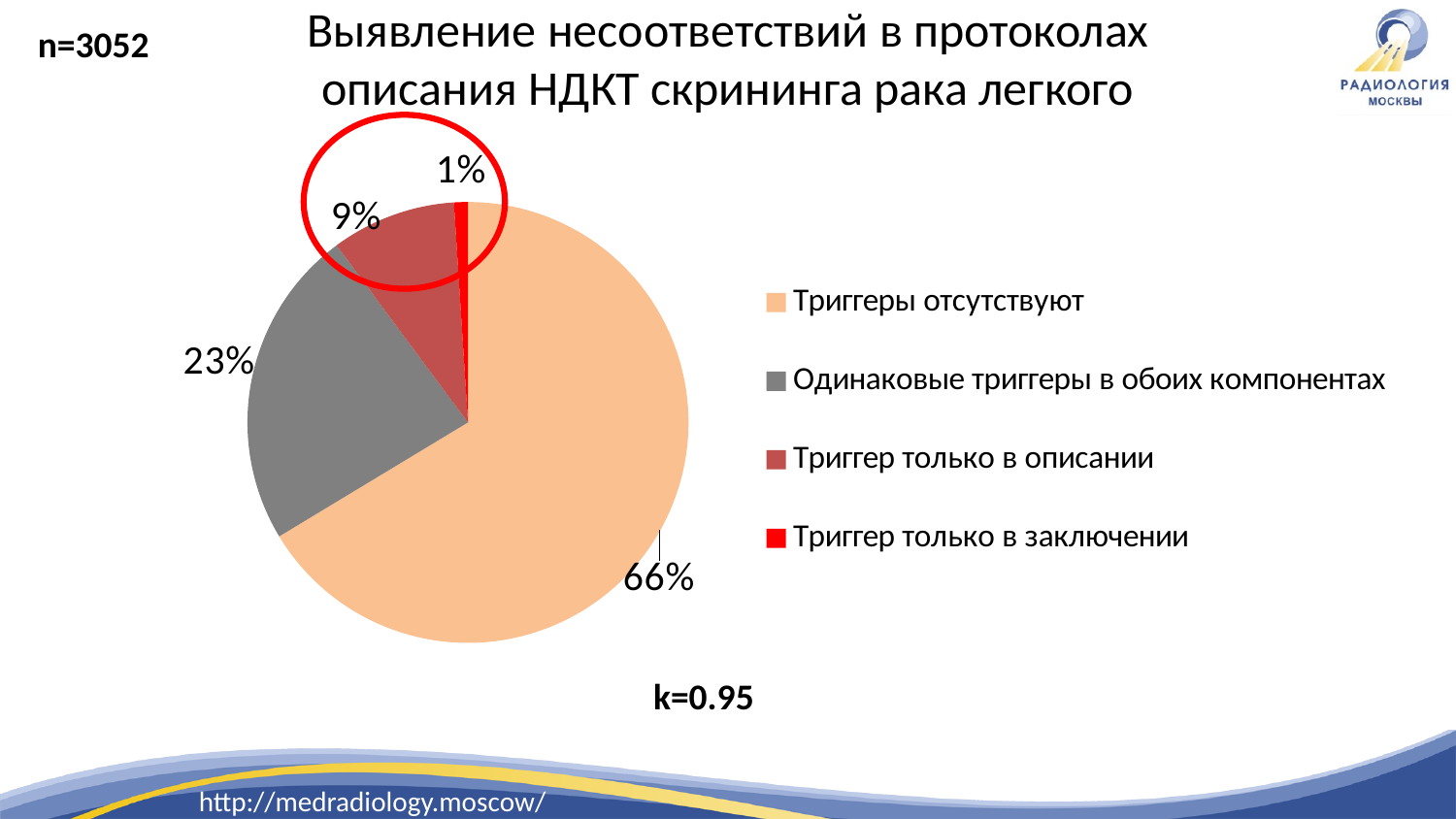
What type of chart is shown on the slide? Pie chart What colour is the slice for "Одинаковые триггеры в обоих компонентах"? Grey What share of the pie does the slice "Триггер только в заключении" represent? 1% What share of the pie does the slice "Одинаковые триггеры в обоих компонентах" represent? 23% What share of the pie does the slice "Триггер только в описании" represent? 9% Which category has the smallest slice of the pie? Триггер только в заключении Which is larger: the slice for "Триггер только в описании" or the slice for "Триггер только в заключении"? Триггер только в описании What is the difference in percentage points between "Триггеры отсутствуют" and "Одинаковые триггеры в обоих компонентах"? 43 How many slices does the pie chart have? 4 Which category has the largest slice of the pie? Триггеры отсутствуют How many entries does the legend list? 4